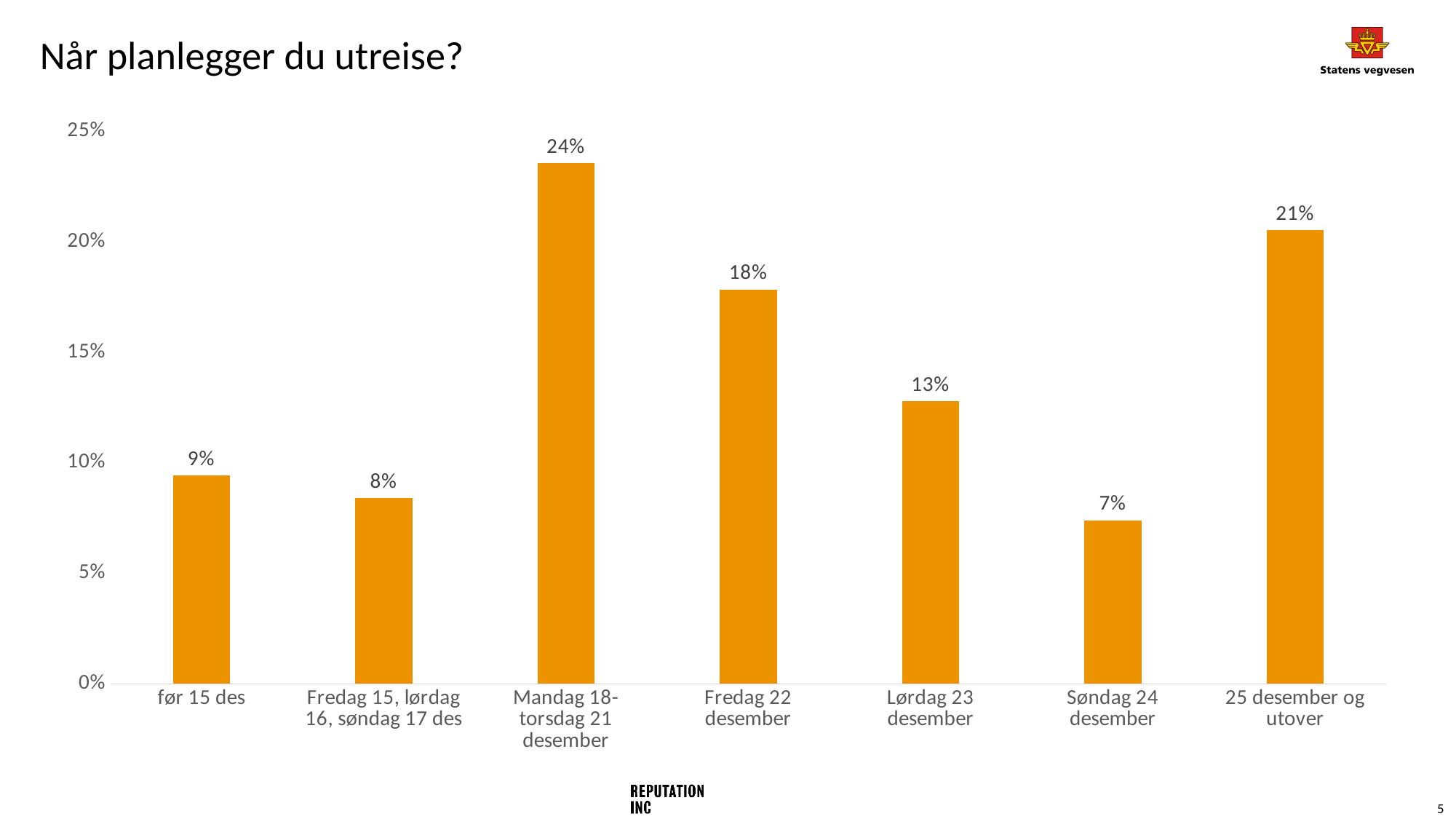
Is the value for "Fredag 22 desember" greater or less than 15%? greater What is the title of the slide? Når planlegger du utreise? What is the value for "Søndag 24 desember"? 7% What is the value for "Mandag 18-torsdag 21 desember"? 24% Which is larger: the value for "før 15 des" or the value for "Fredag 15, lørdag 16, søndag 17 des"? før 15 des What is the difference between the values for "Fredag 22 desember" and "Lørdag 23 desember"? 5% How many categories are shown on the x axis? 7 What is the value for "25 desember og utover"? 21% Which category has the lowest value? Søndag 24 desember Which category has the highest value? Mandag 18-torsdag 21 desember What colour are the bars in the chart? Orange What kind of chart is shown on the slide? Bar chart